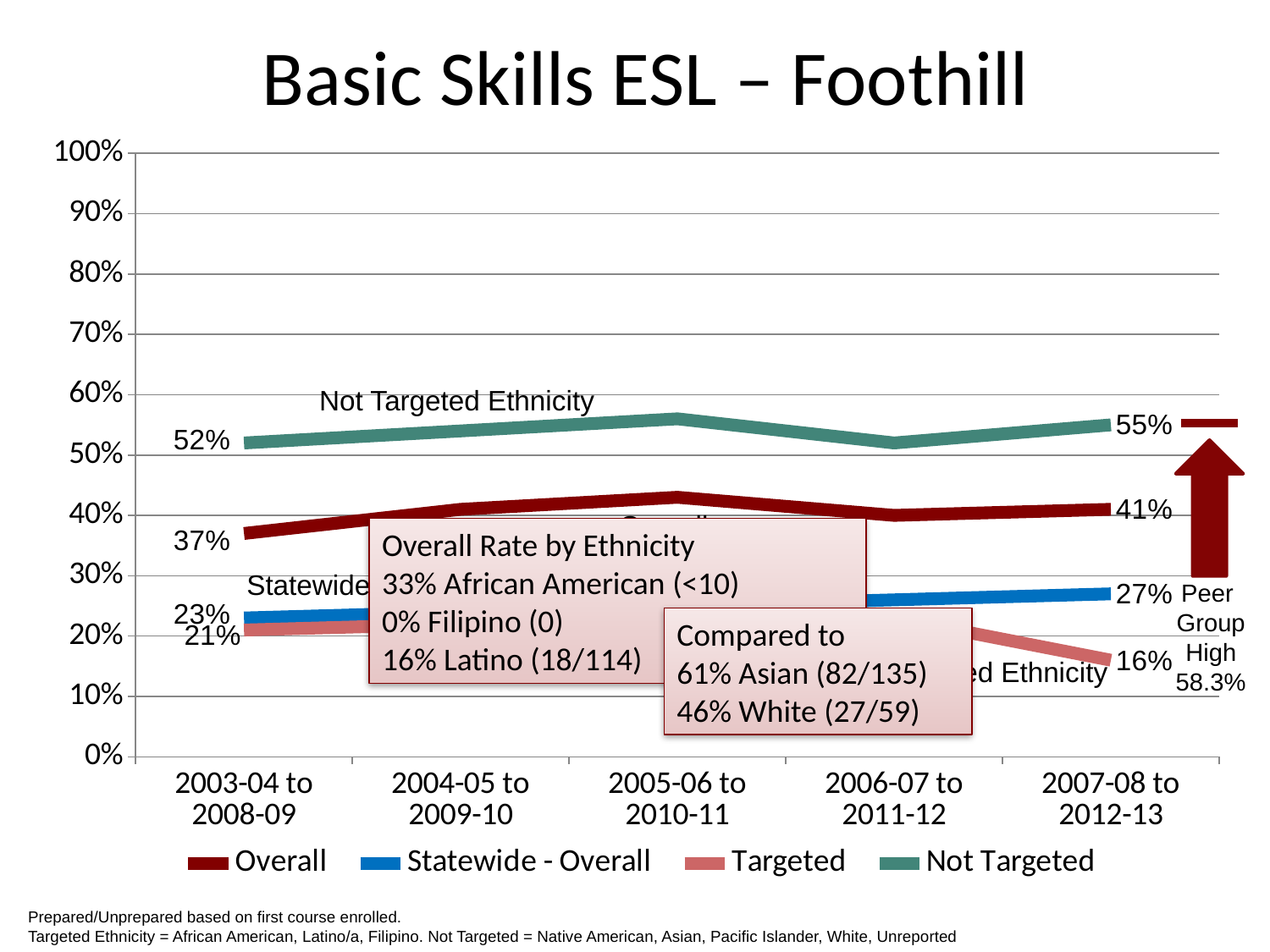
How many time periods are shown on the x axis? 5 What is the difference between the Not Targeted and Overall values in 2007-08 to 2012-13? 14% What is the Statewide - Overall value for 2003-04 to 2008-09? 23% What is the Not Targeted value for 2003-04 to 2008-09? 52% Does the Targeted series rise or fall from 2003-04 to 2008-09 to 2007-08 to 2012-13? fall Which series has the highest value in 2007-08 to 2012-13? Not Targeted Which series has the lowest value in 2007-08 to 2012-13? Targeted Is the Overall value for 2005-06 to 2010-11 greater or less than 40%? greater What is the Overall value for 2007-08 to 2012-13? 41% How many series does the legend list? 4 What is the Targeted value for 2007-08 to 2012-13? 16% What type of chart is shown on the slide? line chart